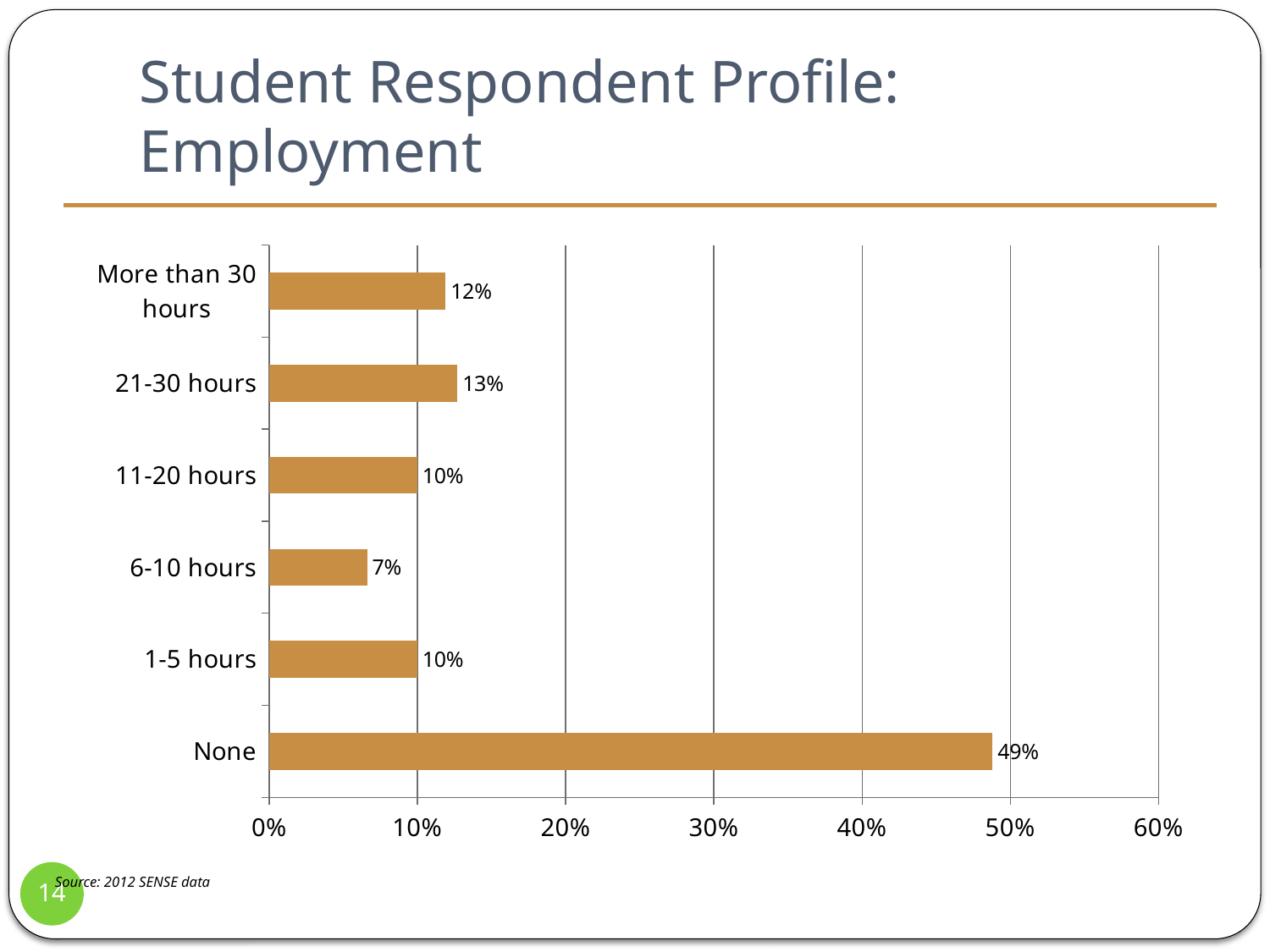
What percentage of respondents work 21-30 hours? 13% What percentage of student respondents reported working None hours? 49% Which employment category has the lowest percentage? 6-10 hours What kind of chart is shown on the slide? Bar chart Which employment category has the highest percentage? None What is the value for the 6-10 hours category? 7% What is the value for More than 30 hours? 12% What is the difference between the None category and the 1-5 hours category? 39% How many employment categories are shown in the chart? 6 Which is larger, the value for 21-30 hours or the value for 11-20 hours? 21-30 hours Is the value for None greater or less than 40%? greater What is the title of the slide containing the chart? Student Respondent Profile: Employment